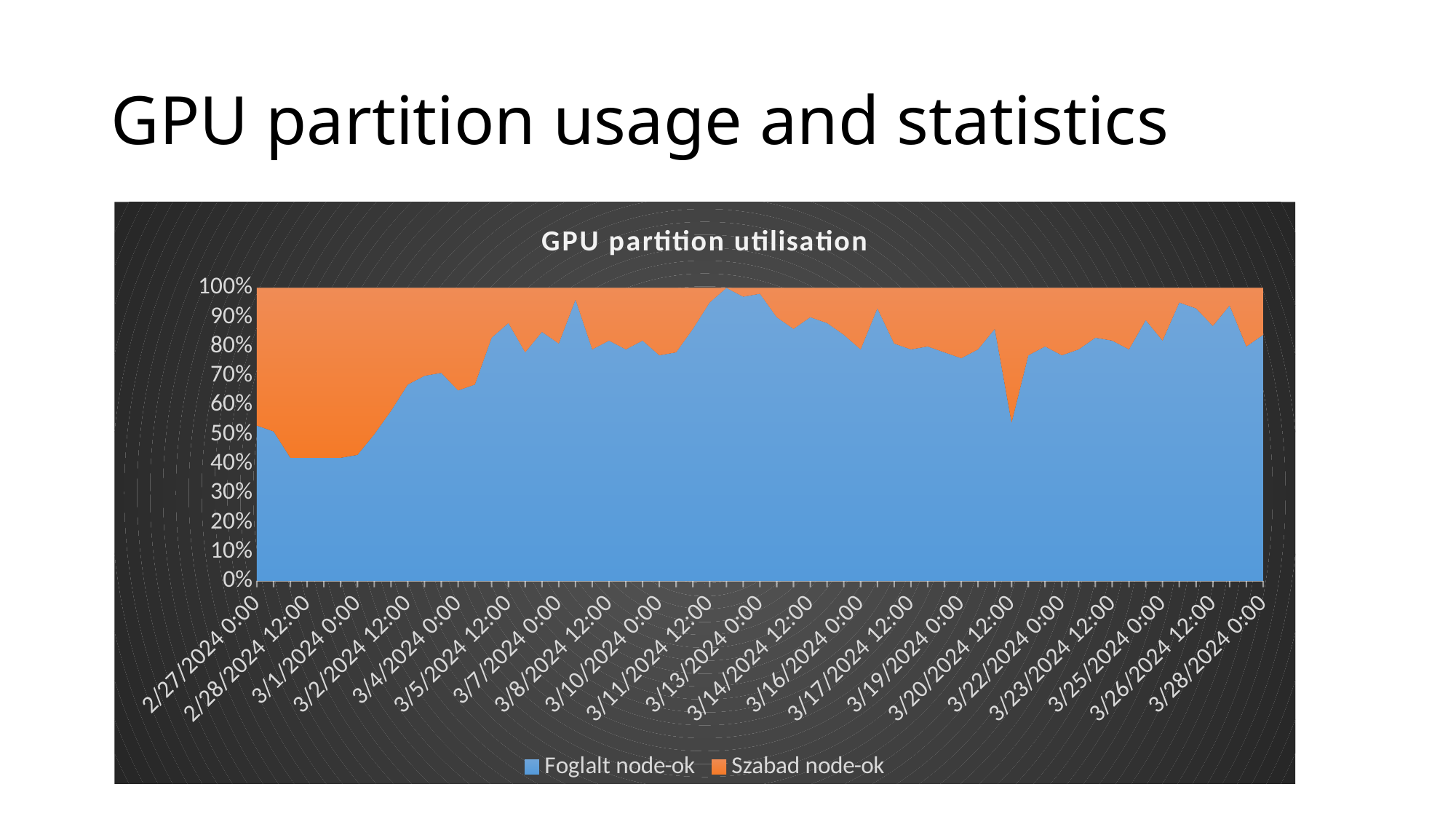
What is the title of the chart? GPU partition utilisation What kind of chart is shown on the slide? area chart Does the Foglalt node-ok share rise or fall between 3/1/2024 0:00 and 3/13/2024 0:00? rise Is the value for Foglalt node-ok at 3/4/2024 0:00 greater or less than 60%? greater Which series has the larger share at 2/28/2024 12:00, Foglalt node-ok or Szabad node-ok? Szabad node-ok Is the value for Foglalt node-ok at 2/28/2024 12:00 greater or less than 50%? less What is the combined total of the two stacked series at any point on the chart? 100% Is the value for Foglalt node-ok at 3/1/2024 0:00 greater or less than 50%? less Which series is shown in orange in the legend? Szabad node-ok How many series does the legend list? 2 Which series has the larger share at 3/13/2024 0:00, Foglalt node-ok or Szabad node-ok? Foglalt node-ok